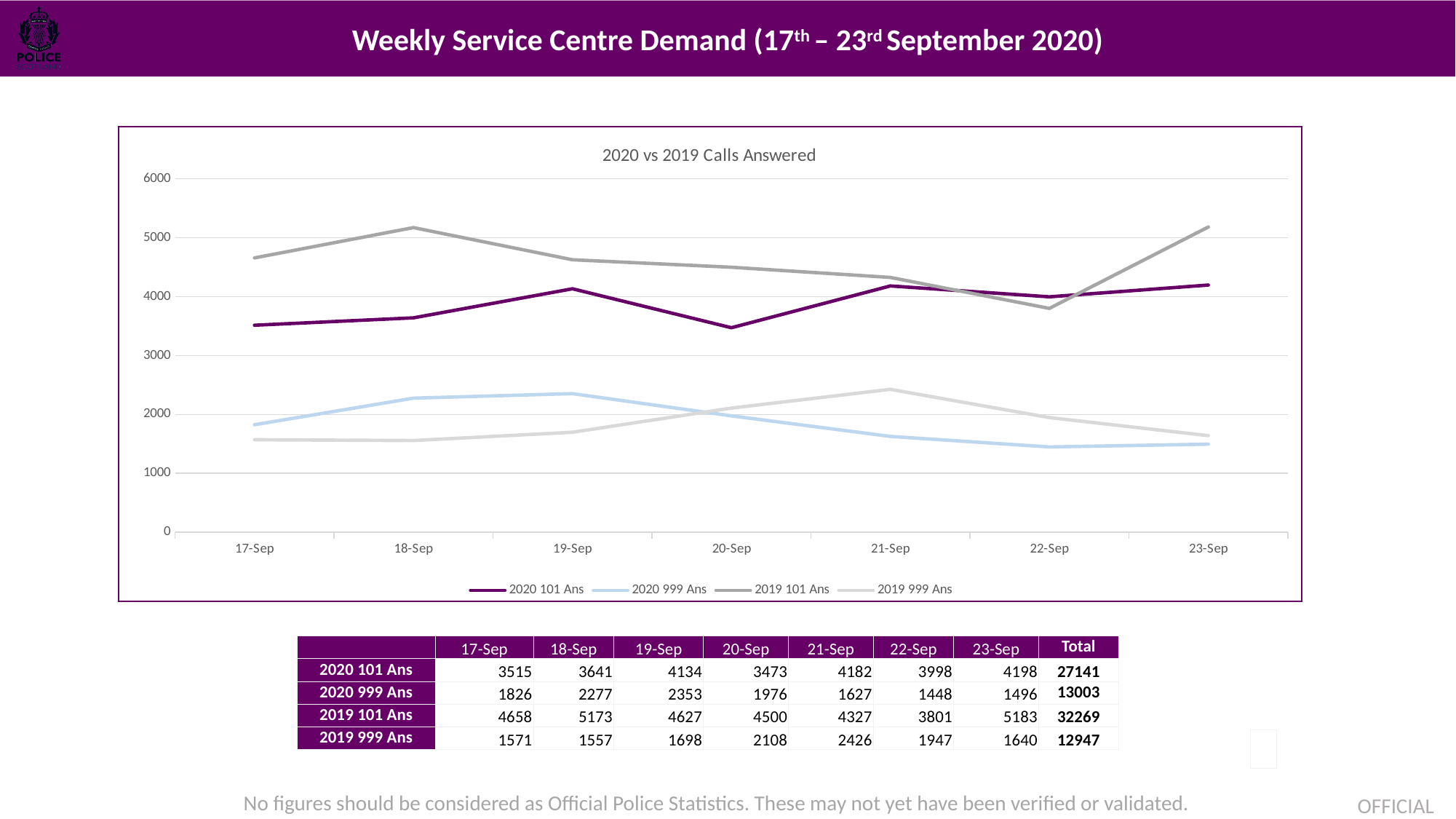
What is the value for 2019 999 Ans on 21-Sep? 2426 On 20-Sep, which is larger: 2020 999 Ans or 2019 999 Ans? 2019 999 Ans On which date is 2019 101 Ans at its lowest? 22-Sep What is the difference between the weekly totals for 2019 101 Ans and 2020 101 Ans? 5128 Is the value for 2019 101 Ans on 18-Sep greater or less than 5000? greater What is the weekly total for 2020 101 Ans? 27141 What is the value for 2020 101 Ans on 19-Sep? 4134 What type of chart is shown on the slide? Line chart How many dates are plotted along the x axis? 7 On which date is 2019 999 Ans at its highest? 21-Sep How many series does the chart legend list? 4 What is the title of the chart? 2020 vs 2019 Calls Answered